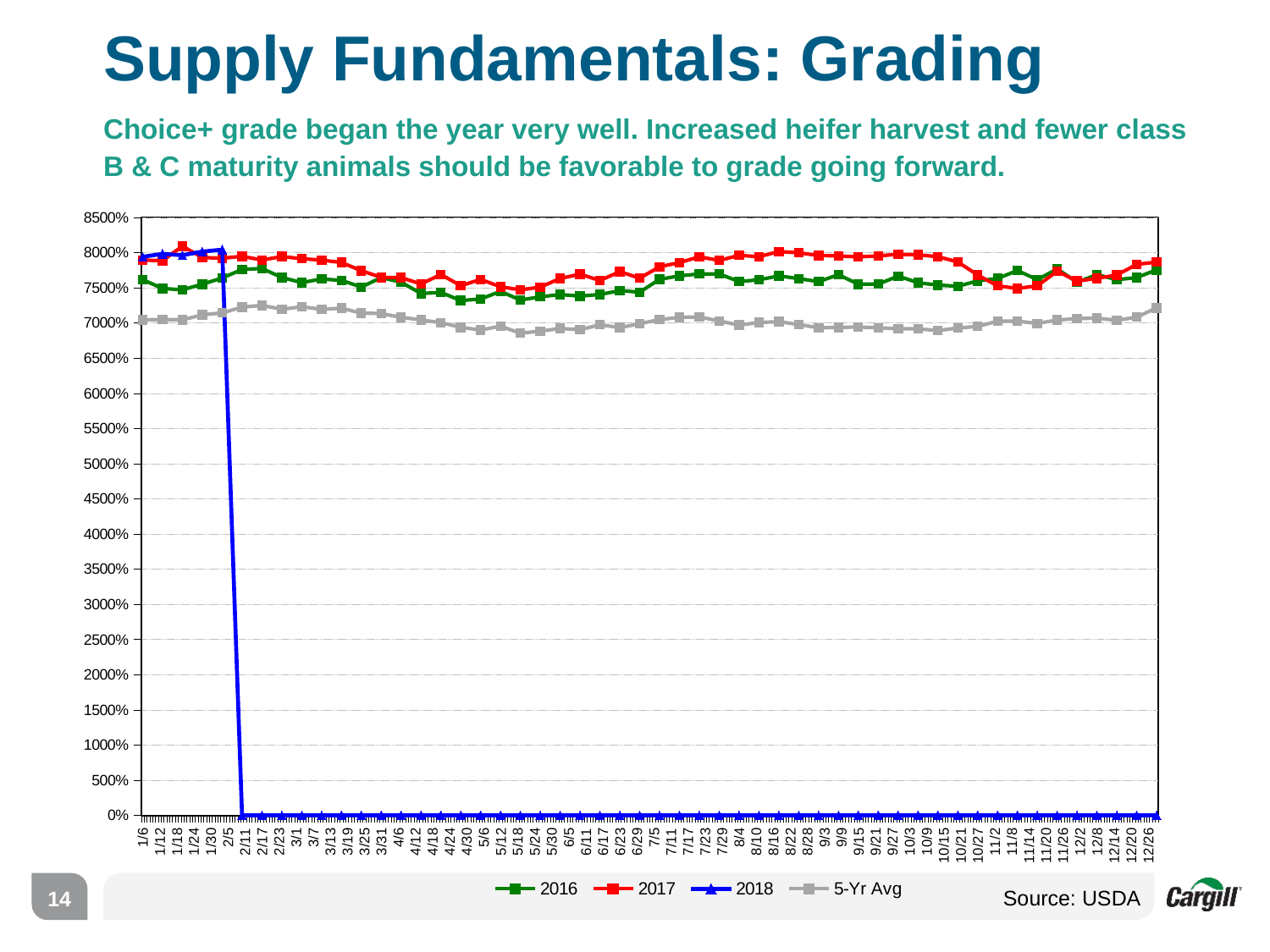
Is the 2016 value at 8/16 greater or less than 7500%? greater What kind of chart is shown on the slide? line chart What is the highest value shown on the y axis? 8500% How many series does the legend list? 4 Does the 2018 line rise or fall between 2/5 and 2/11? fall At 7/17, which series has the higher value, 2016 or 5-Yr Avg? 2016 At 1/6, which series has the higher value, 2017 or 5-Yr Avg? 2017 Which series has the lowest value at 12/26? 2018 Is the 2018 value at 2/11 greater or less than 500%? less What are the series names listed in the legend? 2016, 2017, 2018, 5-Yr Avg Is the 5-Yr Avg value at 1/6 greater or less than 7500%? less